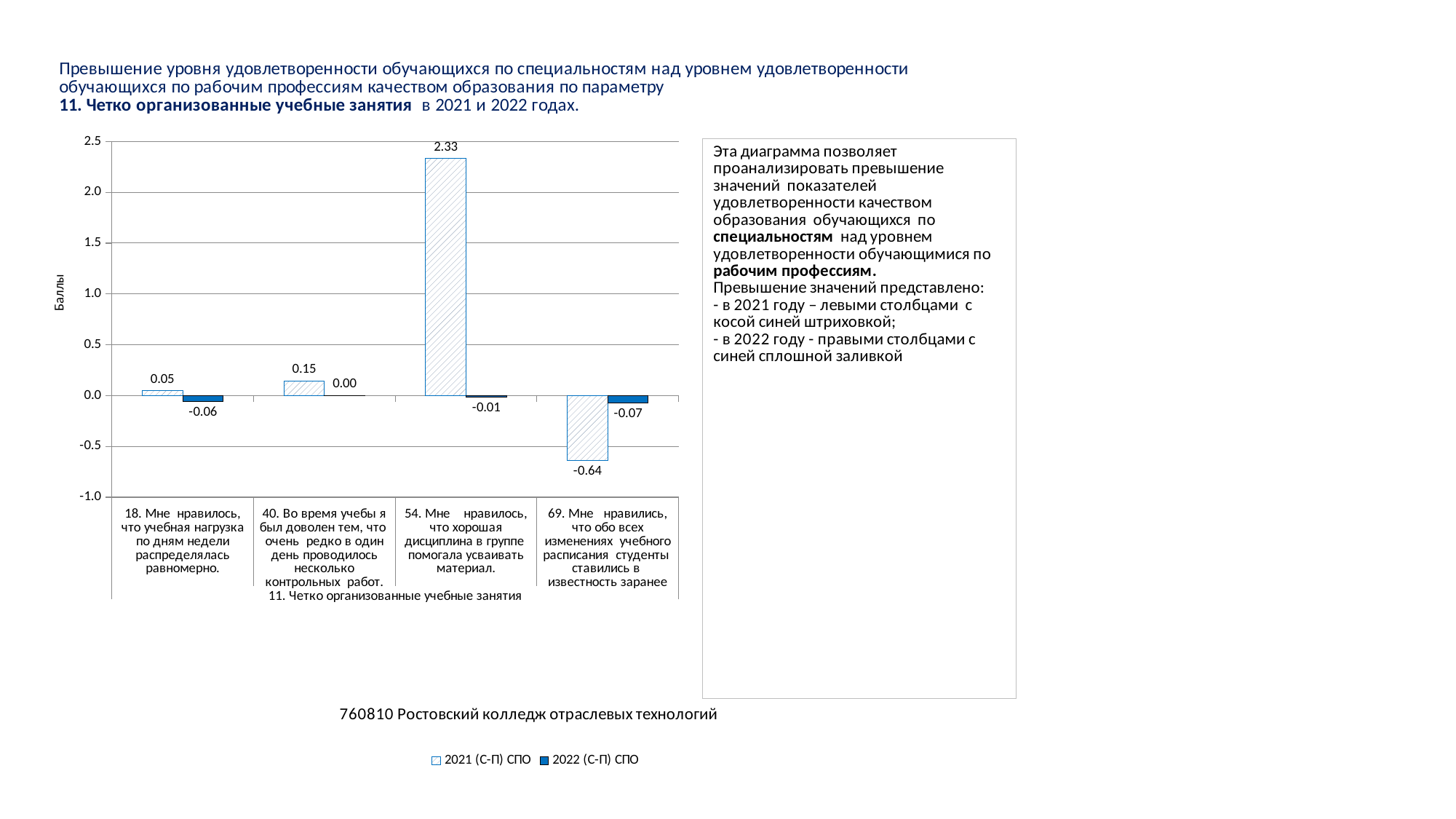
How many series does the chart legend list? 2 What is the difference between the 2021 (С-П) СПО value and the 2022 (С-П) СПО value for category 54? 2.34 How many categories are shown on the x axis of the chart? 4 What is the 2021 (С-П) СПО value for category 69 (Мне нравились, что обо всех изменениях учебного расписания студенты ставились в известность заранее)? -0.64 Which category has the highest 2021 (С-П) СПО value? 54. Мне нравилось, что хорошая дисциплина в группе помогала усваивать материал. Which category has the lowest 2021 (С-П) СПО value? 69. Мне нравились, что обо всех изменениях учебного расписания студенты ставились в известность заранее For category 18, which is larger: the 2021 (С-П) СПО value or the 2022 (С-П) СПО value? 2021 (С-П) СПО What is the label of the vertical axis of the chart? Баллы What is the 2021 (С-П) СПО value for category 54 (Мне нравилось, что хорошая дисциплина в группе помогала усваивать материал)? 2.33 What is the 2022 (С-П) СПО value for category 40 (Во время учебы я был доволен тем, что очень редко в один день проводилось несколько контрольных работ)? 0.00 What is the 2022 (С-П) СПО value for category 18 (Мне нравилось, что учебная нагрузка по дням недели распределялась равномерно)? -0.06 What type of chart is shown on the slide? bar chart